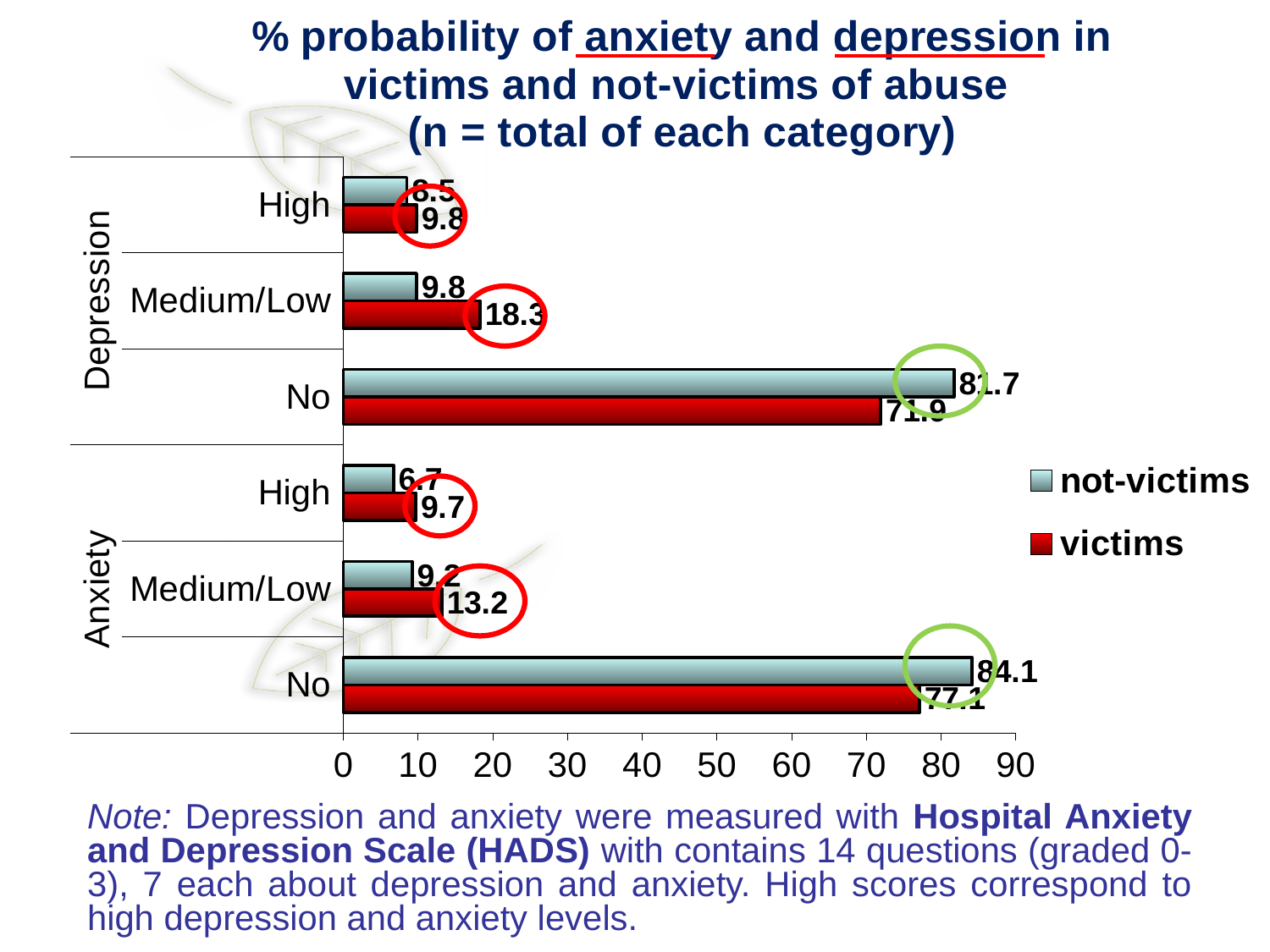
Is the value for victims in the Depression No category greater or less than 70? greater How many series does the legend list? 2 What kind of chart is shown on the slide? bar chart What is the difference between not-victims and victims in the Depression No category? 9.8 Which bar has the highest value on the chart? not-victims, Anxiety No (84.1) What is the value for victims in the Anxiety Medium/Low category? 13.2 What is the difference between not-victims and victims in the Anxiety No category? 7.0 What is the value for not-victims in the Anxiety High category? 6.7 What is the value for not-victims in the Anxiety No category? 84.1 What is the value for victims in the Depression Medium/Low category? 18.3 What is the value for victims in the Anxiety High category? 9.7 In the Depression Medium/Low category, which series has the larger value, victims or not-victims? victims